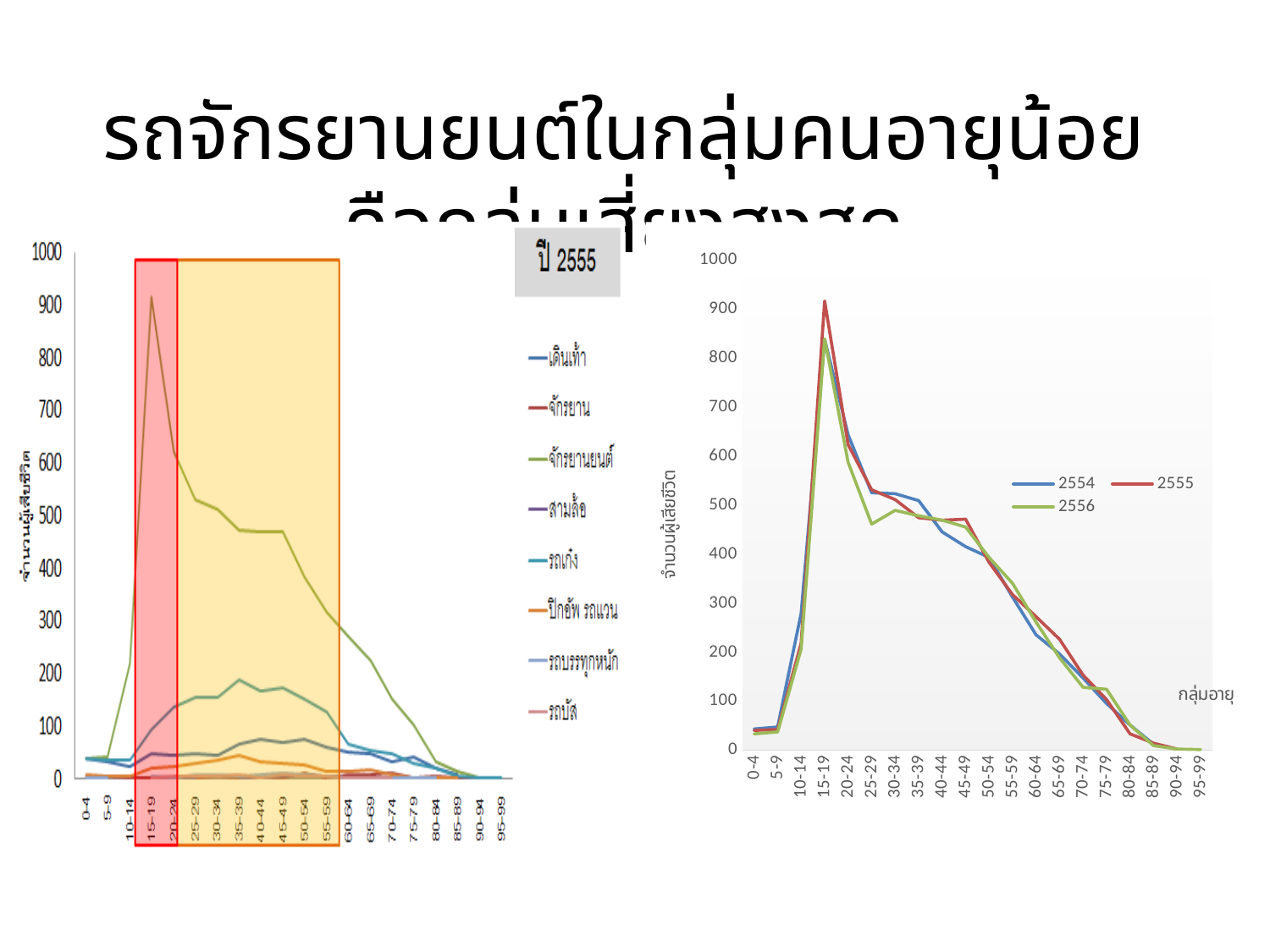
In the left-hand chart (ปี 2555), is the value for จักรยานยนต์ at age group 60-64 greater or less than 300? less In the left-hand chart (ปี 2555), at age group 15-19, which is larger: จักรยานยนต์ or รถเก๋ง? จักรยานยนต์ In the left-hand chart (ปี 2555), is the value for จักรยานยนต์ at age group 15-19 greater or less than 800? greater In the right-hand chart, which series has the highest value at age group 15-19? 2555 How many series does the legend of the left-hand chart (ปี 2555) list? 8 How many age-group categories are shown on the x axis of the right-hand chart? 20 In the left-hand chart (ปี 2555), which age group has the highest value for จักรยานยนต์? 15-19 How many series does the legend of the right-hand chart list? 3 In the right-hand chart, is the value for 2556 at age group 25-29 greater or less than 500? less What is the title shown above the left-hand chart? ปี 2555 What kind of chart is the right-hand chart on the slide? line chart In the right-hand chart, do the values for 2555 rise or fall from age group 15-19 to 95-99? fall